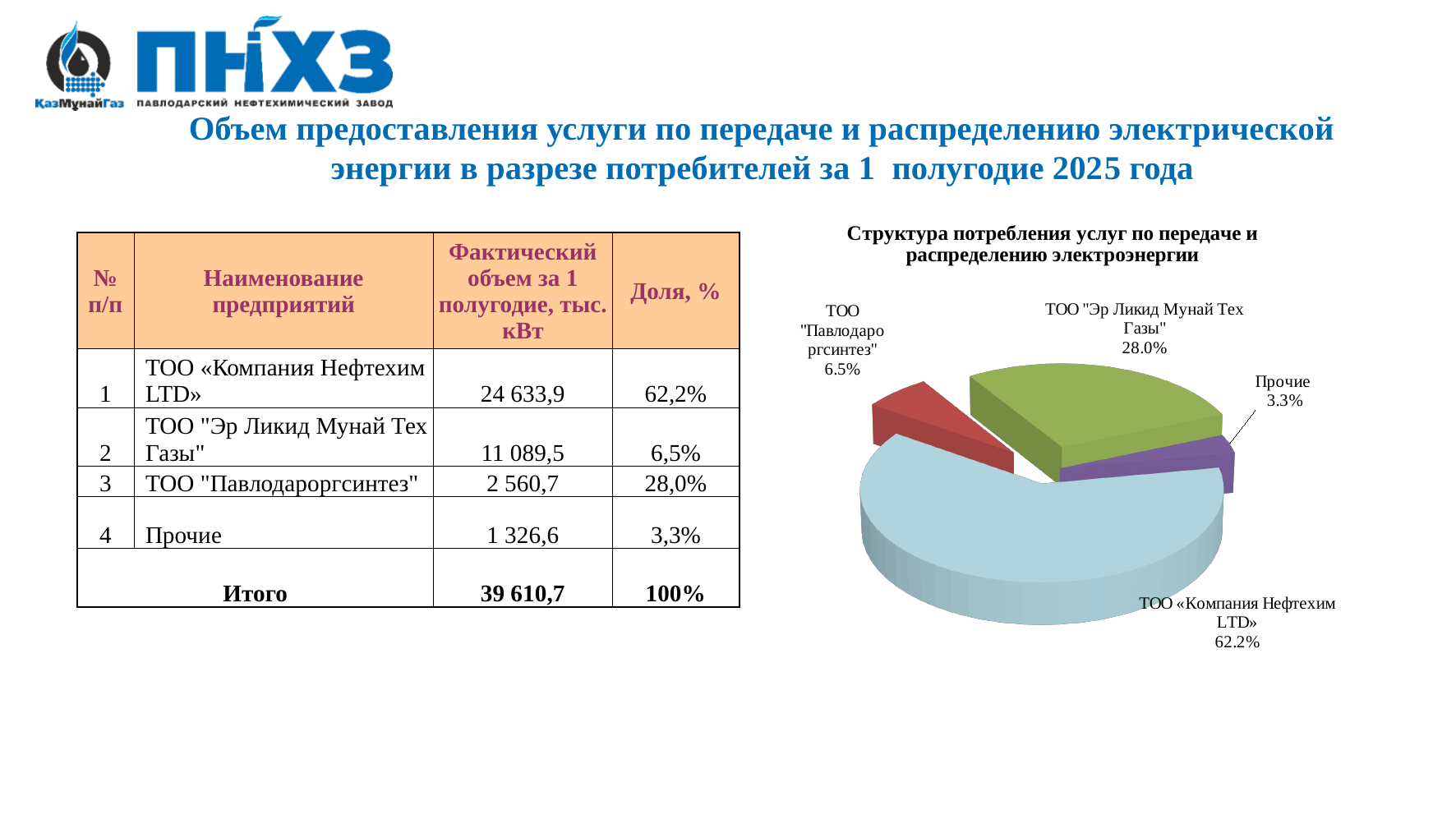
Which category has the largest slice in the pie chart? ТОО «Компания Нефтехим LTD» What share does Прочие have in the pie chart? 3.3% What kind of chart is shown on the slide? Pie chart How many slices does the pie chart have? 4 What share does ТОО "Павлодароргсинтез" have in the pie chart? 6.5% What is the title of the pie chart? Структура потребления услуг по передаче и распределению электроэнергии Which category has the smallest slice in the pie chart? Прочие What share does ТОО "Эр Ликид Мунай Тех Газы" have in the pie chart? 28.0% In the pie chart, what is the difference in percentage points between the share of ТОО «Компания Нефтехим LTD» and the share of ТОО "Эр Ликид Мунай Тех Газы"? 34.2 percentage points In the pie chart, what colour is the slice for ТОО «Компания Нефтехим LTD»? Light blue In the pie chart, which is larger: the slice for ТОО "Эр Ликид Мунай Тех Газы" or the slice for ТОО "Павлодароргсинтез"? ТОО "Эр Ликид Мунай Тех Газы"